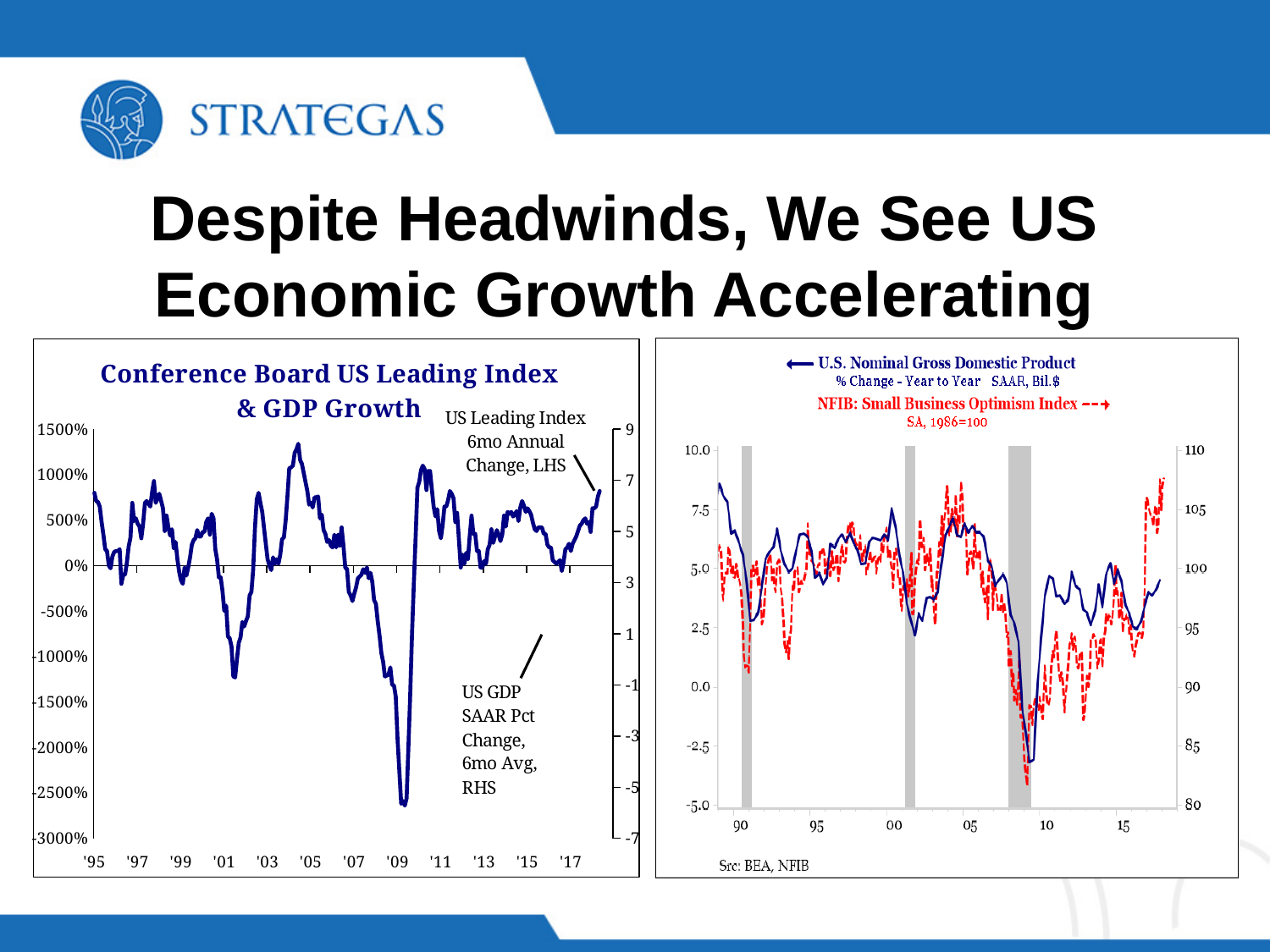
How many series does the legend of the right chart list? 2 What kind of chart is the right chart showing U.S. Nominal Gross Domestic Product and the NFIB Small Business Optimism Index? line chart In the right chart, does the NFIB Small Business Optimism Index rise or fall from around 2016 to the end of the series? rise In the left chart, is the peak of the line around '05 greater or less than 1000%? greater What source is cited at the bottom of the right chart? BEA, NFIB In the left chart, around which year label does the line reach its lowest point? '09 In the right chart, is the NFIB Small Business Optimism Index at the far right end of the chart greater or less than 105 on the right-hand axis? greater What kind of chart is the left chart titled 'Conference Board US Leading Index & GDP Growth'? line chart In the left chart, is the lowest value of the line (around '09) greater or less than -2000%? less How many year labels are shown on the x axis of the right chart? 6 In the right chart, which series is drawn as a red dashed line? NFIB: Small Business Optimism Index